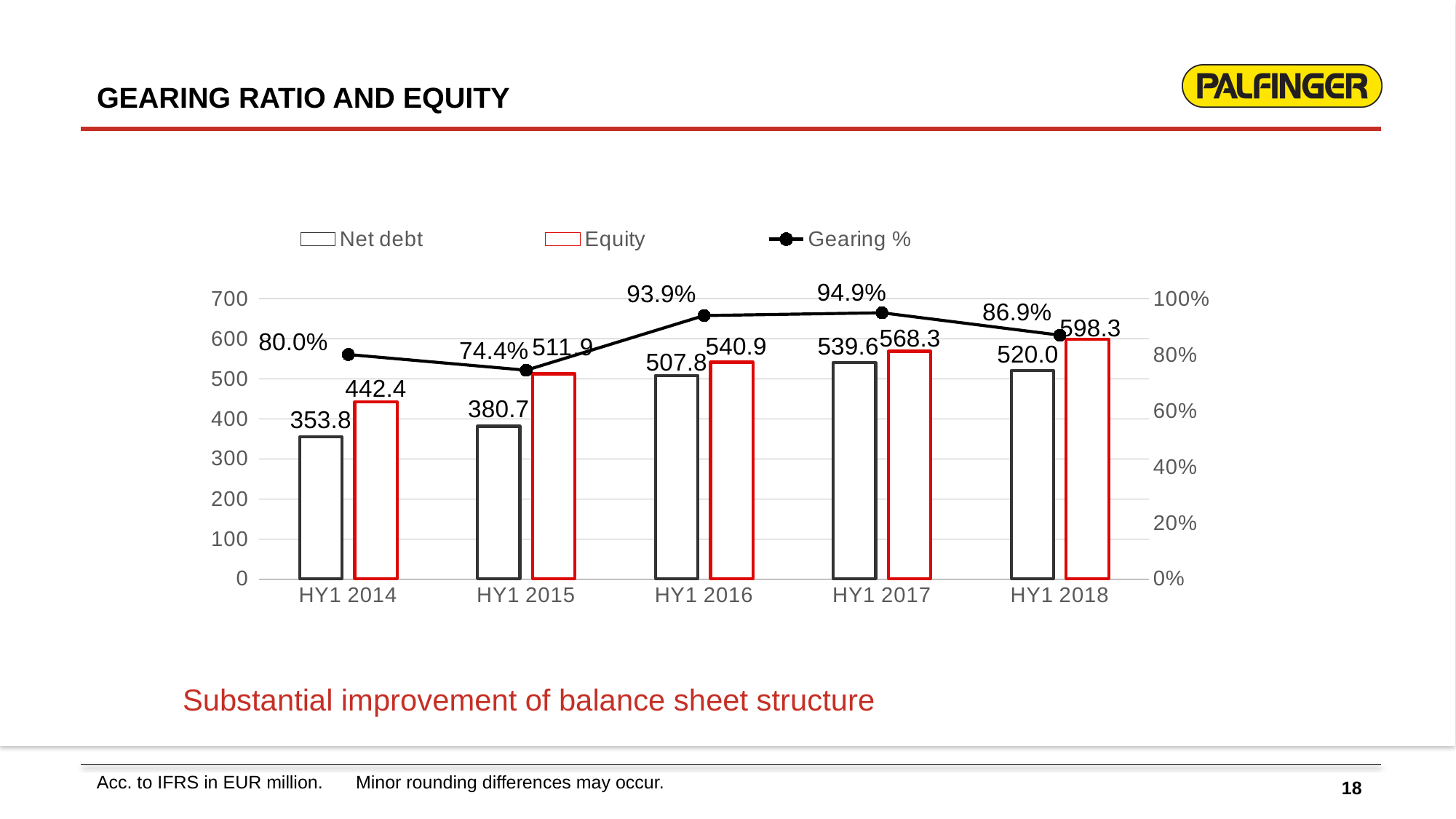
In which period is the Gearing % highest? HY1 2017 In which period is Net debt lowest? HY1 2014 What is the Equity value for HY1 2018? 598.3 How many series does the legend list? 3 Which series is plotted as a line with markers? Gearing % Which is larger in HY1 2017: Net debt or Equity? Equity Does Equity rise or fall from HY1 2014 to HY1 2018? rise What is the Net debt value for HY1 2016? 507.8 What is the Gearing % for HY1 2015? 74.4% How many periods are shown on the x axis? 5 What is the difference between Equity and Net debt in HY1 2014? 88.6 Is the Equity value for HY1 2015 greater or less than 500? greater